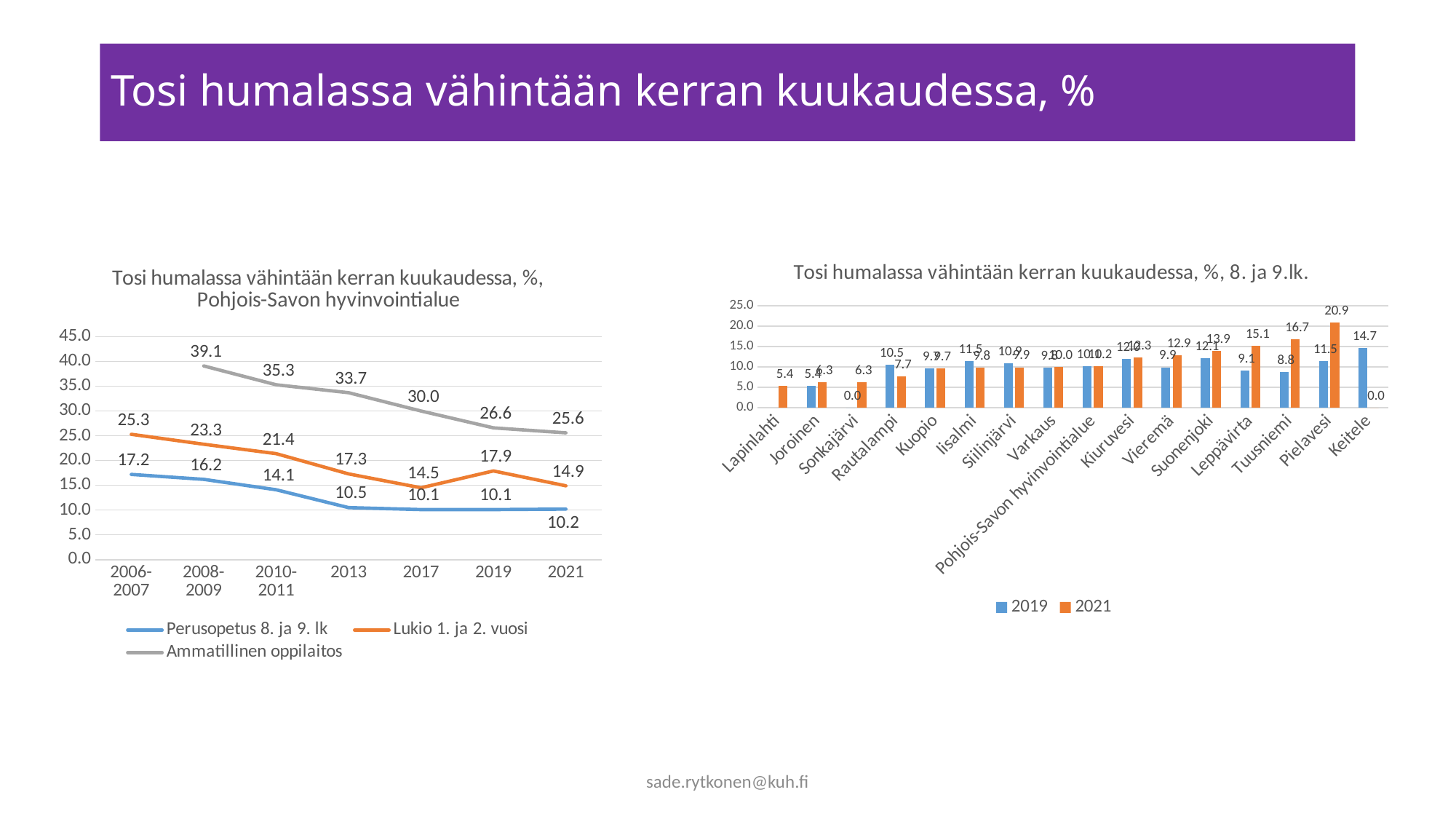
In the right chart (8. ja 9.lk.), which municipality has the highest 2021 value? Pielavesi In the left chart (Pohjois-Savon hyvinvointialue), what is the difference between the Ammatillinen oppilaitos value in 2008-2009 and in 2021? 13.5 What kind of chart is the right chart (8. ja 9.lk.)? bar chart In the left chart (Pohjois-Savon hyvinvointialue), how many series does the legend list? 3 In the right chart (8. ja 9.lk.), what is the 2021 value for Tuusniemi? 16.7 In the left chart (Pohjois-Savon hyvinvointialue), what is the value for Lukio 1. ja 2. vuosi in 2019? 17.9 In the left chart (Pohjois-Savon hyvinvointialue), does the Ammatillinen oppilaitos line rise or fall from 2008-2009 to 2021? fall In the left chart (Pohjois-Savon hyvinvointialue), what is the value for Perusopetus 8. ja 9. lk in 2006-2007? 17.2 In the right chart (8. ja 9.lk.), which is larger for Leppävirta: the 2019 value or the 2021 value? 2021 In the right chart (8. ja 9.lk.), what is the 2019 value for Keitele? 14.7 In the left chart (Pohjois-Savon hyvinvointialue), what is the value for Ammatillinen oppilaitos in 2021? 25.6 What kind of chart is the left chart (Pohjois-Savon hyvinvointialue)? line chart